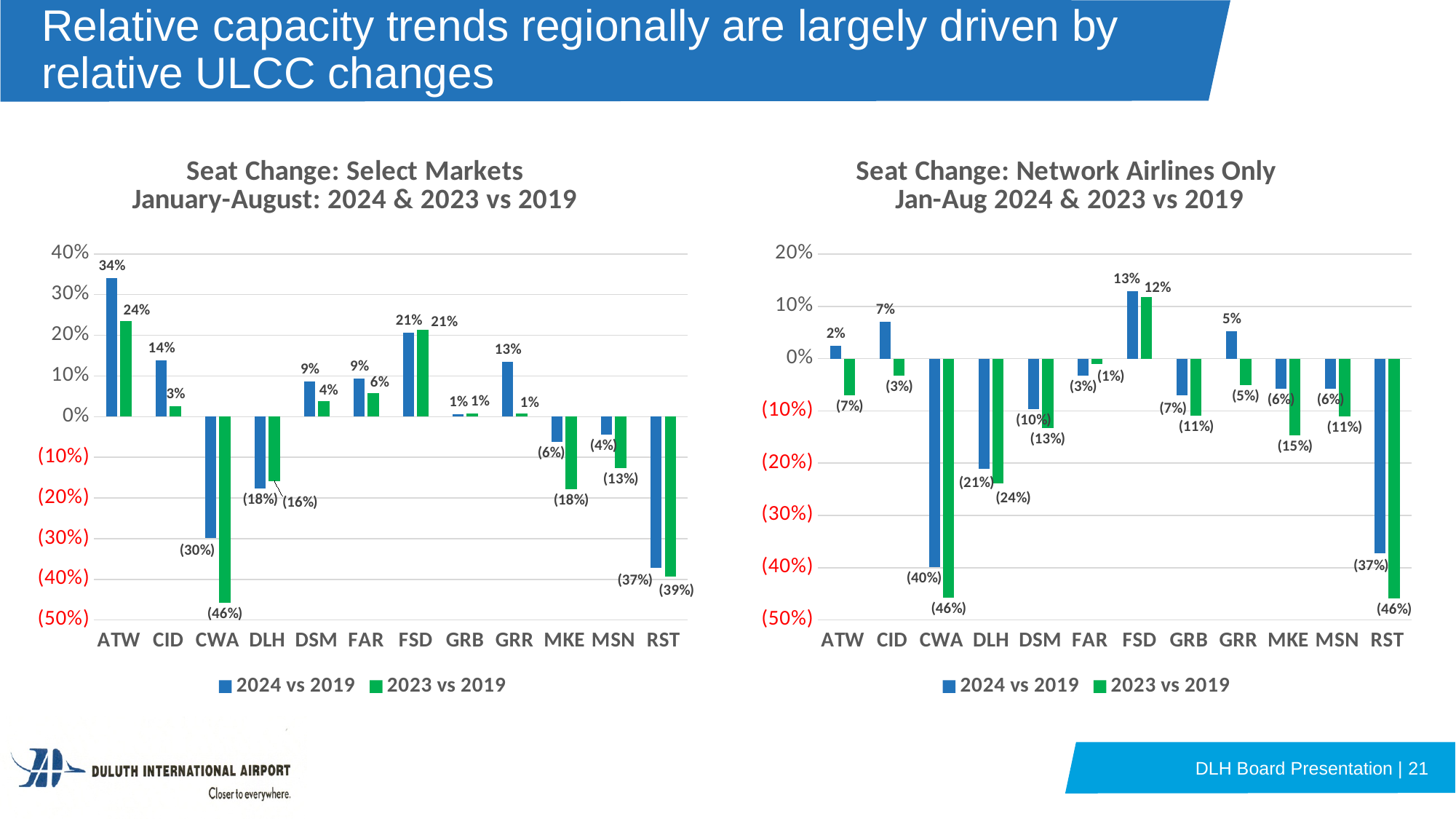
In the 'Seat Change: Select Markets' chart, what is the 2023 vs 2019 value for CWA? (46%) In the 'Seat Change: Select Markets' chart, which market has the lowest 2024 vs 2019 value? RST In the 'Seat Change: Network Airlines Only' chart, what is the 2024 vs 2019 value for FSD? 13% What type of chart is the 'Seat Change: Select Markets' chart? Bar chart In the 'Seat Change: Select Markets' chart, what is the difference between the 2024 vs 2019 and 2023 vs 2019 values for GRR? 12 percentage points In the 'Seat Change: Network Airlines Only' chart, which market has the lowest 2023 vs 2019 value? CWA and RST (both (46%)) In the 'Seat Change: Select Markets' chart, how many markets are shown on the x axis? 12 In the 'Seat Change: Select Markets' chart, what is the 2024 vs 2019 value for ATW? 34% In the 'Seat Change: Network Airlines Only' chart, which is larger for DLH: the 2024 vs 2019 value or the 2023 vs 2019 value? 2024 vs 2019 How many series does the legend of the 'Seat Change: Network Airlines Only' chart list? 2 In the 'Seat Change: Select Markets' chart, which market has the highest 2024 vs 2019 value? ATW In the 'Seat Change: Network Airlines Only' chart, what is the 2023 vs 2019 value for MKE? (15%)